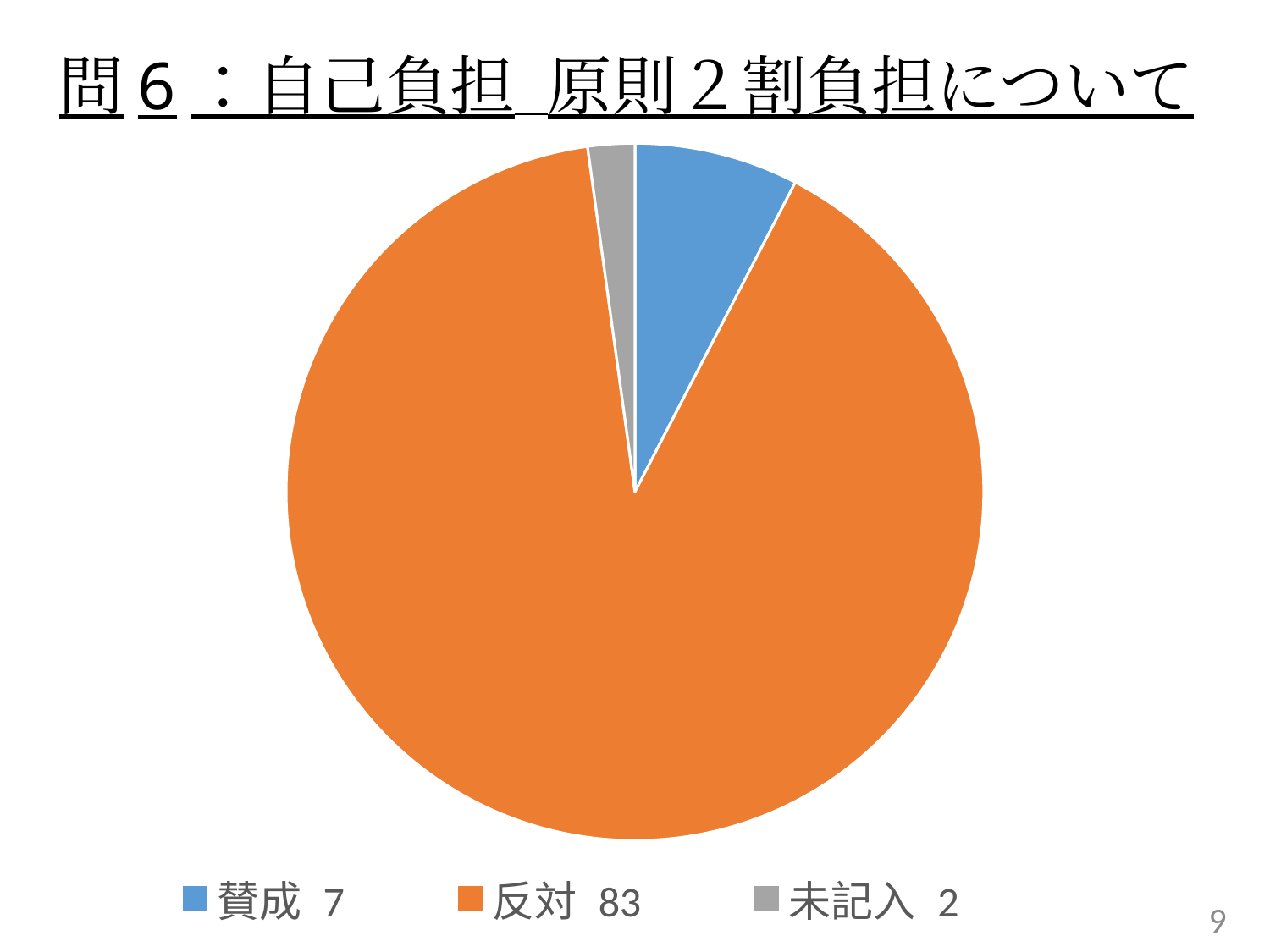
What value is shown for 賛成 in the pie chart? 7 What is the total of all values shown in the pie chart? 92 What is the difference between the values for 賛成 and 未記入? 5 Which category has the smallest slice of the pie chart? 未記入 What is the difference between the values for 反対 and 賛成? 76 Which is larger, the value for 賛成 or the value for 未記入? 賛成 How many categories are shown in the pie chart? 3 What colour is the slice for 反対? Orange What value is shown for 未記入 in the pie chart? 2 What value is shown for 反対 in the pie chart? 83 What kind of chart is shown on the slide? Pie chart Which category has the largest slice of the pie chart? 反対